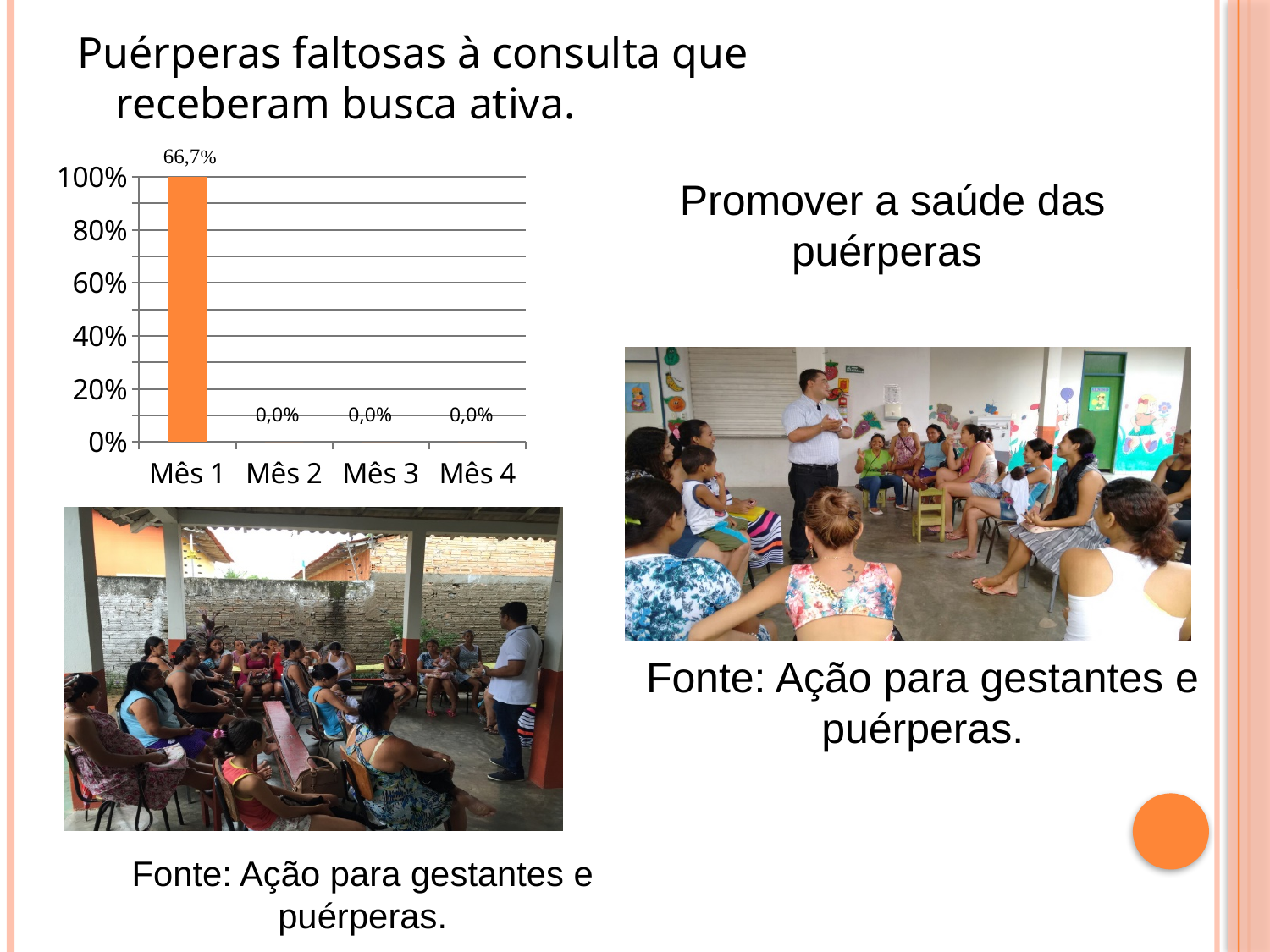
What is the difference between the values for Mês 1 and Mês 3? 66,7% Do the values rise or fall from Mês 1 to Mês 2? fall What value is shown for Mês 4 in the chart? 0,0% What kind of chart is shown on the slide? bar chart Which is larger, the value for Mês 1 or the value for Mês 2? Mês 1 What colour is the bar for Mês 1? orange How many months are shown on the x axis of the chart? 4 Which month has the highest value in the chart? Mês 1 What value is shown for Mês 1 in the chart? 66,7% What is the title of the chart on the slide? Puérperas faltosas à consulta que receberam busca ativa. What value is shown for Mês 2 in the chart? 0,0% Is the value for Mês 1 greater or less than 40%? greater